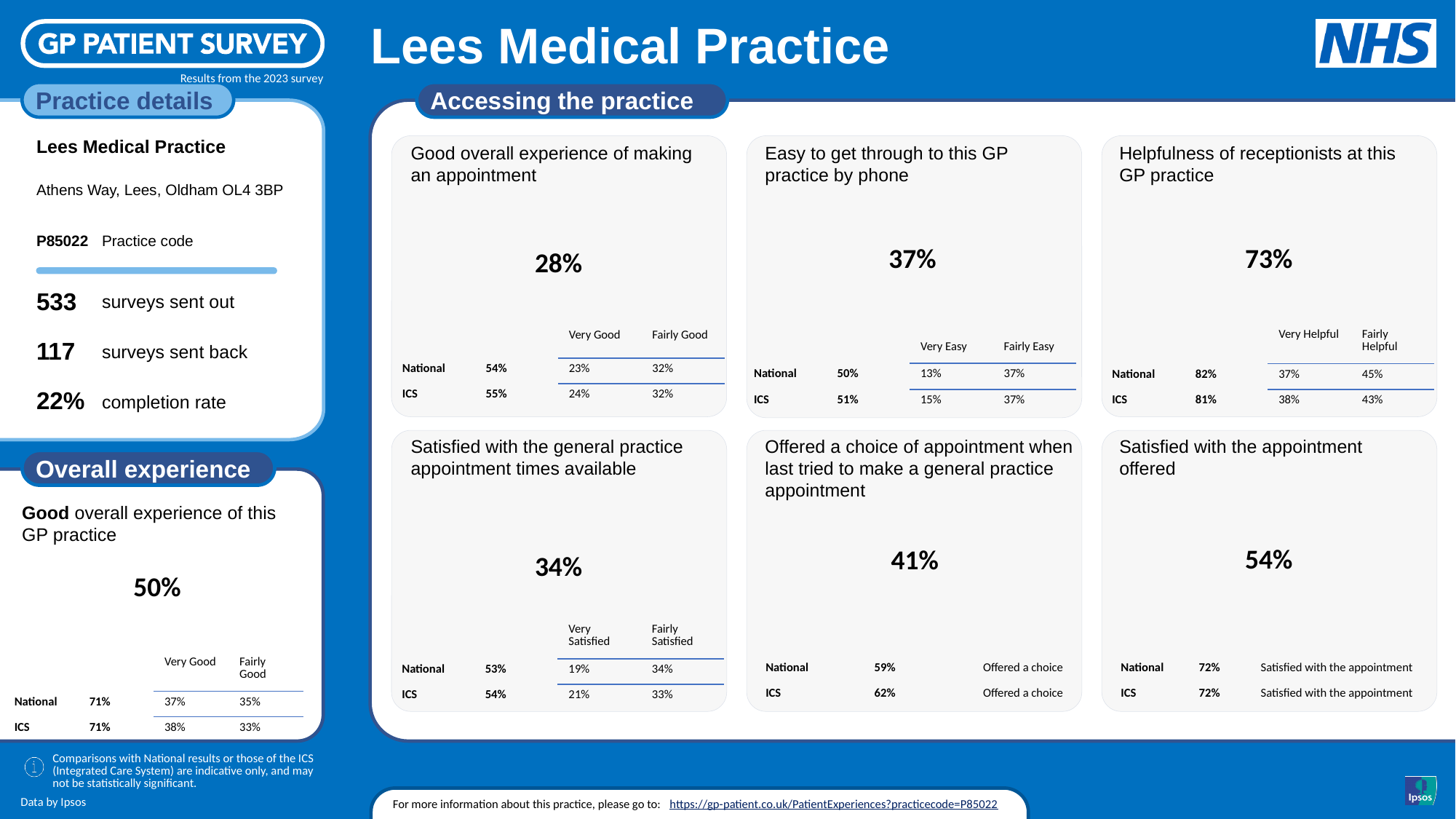
On the 'Good overall experience of making an appointment' panel, what is the practice's headline percentage? 28% On the 'Good overall experience of this GP practice' panel, what is the practice's headline percentage? 50% On the 'Satisfied with the general practice appointment times available' panel, what is the National value for Fairly Satisfied? 34% On the 'Offered a choice of appointment when last tried to make a general practice appointment' panel, what is the ICS value? 62% Among the six 'Accessing the practice' panels, which has the highest headline percentage? Helpfulness of receptionists at this GP practice On the 'Helpfulness of receptionists at this GP practice' panel, what is the ICS value for Very Helpful? 38% On the 'Satisfied with the appointment offered' panel, what is the difference between the National value and the practice's headline percentage? 18% Among the six 'Accessing the practice' panels, which has the lowest headline percentage? Good overall experience of making an appointment On the 'Easy to get through to this GP practice by phone' panel, what is the National value? 50% On the 'Easy to get through to this GP practice by phone' panel, which is larger: the National value or the practice's headline percentage? National On the 'Good overall experience of making an appointment' panel, what are the two breakdown column headings? Very Good, Fairly Good How many panels are shown under the 'Accessing the practice' heading? 6